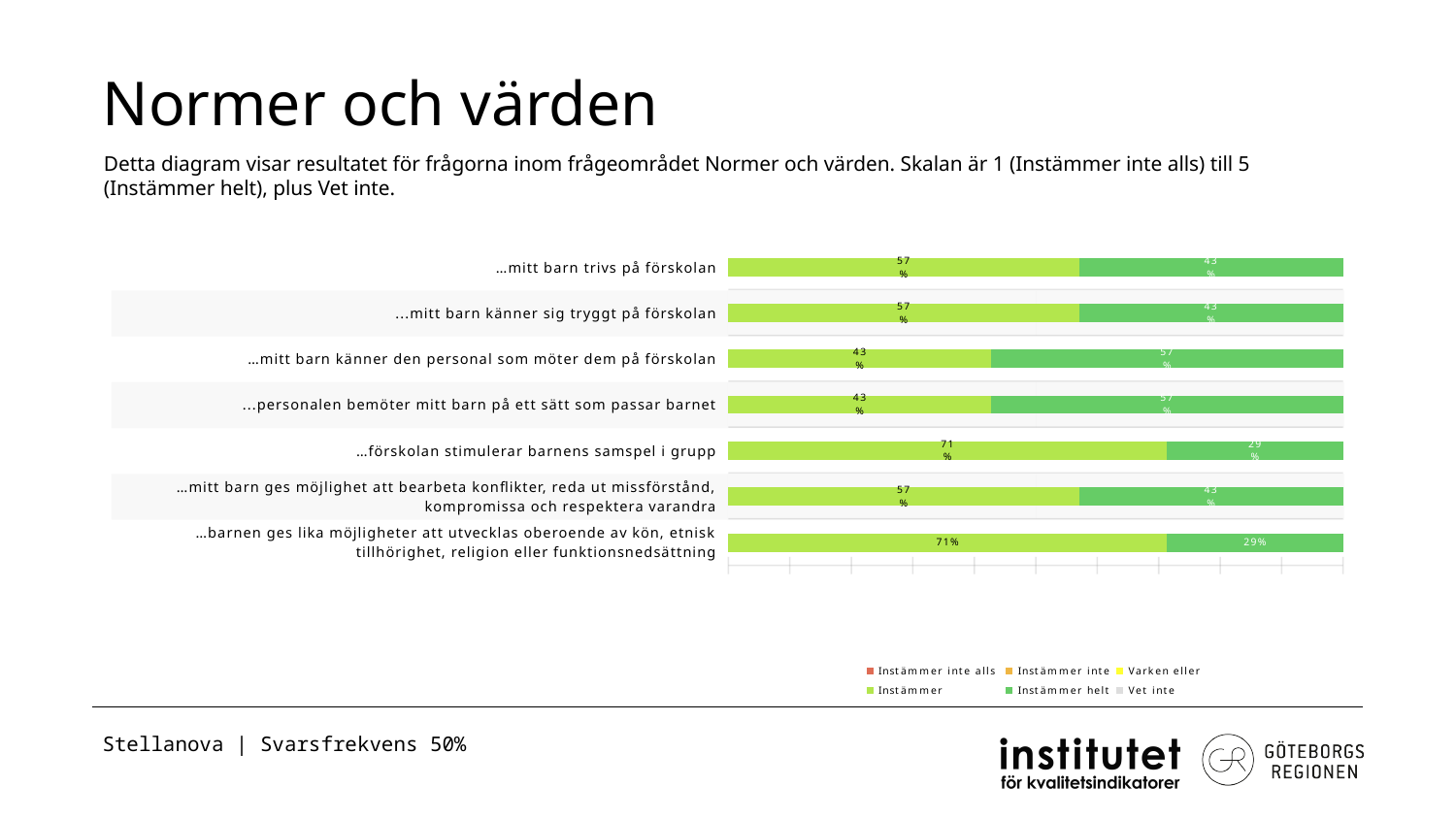
What is the title of the slide containing the chart? Normer och värden What kind of chart is shown on the slide? stacked bar chart How many categories (questions) are plotted in the chart? 7 Which category has the lowest Instämmer helt value? …förskolan stimulerar barnens samspel i grupp and …barnen ges lika möjligheter att utvecklas oberoende av kön, etnisk tillhörighet, religion eller funktionsnedsättning (29%) Which is larger for "…mitt barn känner sig tryggt på förskolan": Instämmer or Instämmer helt? Instämmer What is the total of the stacked bar for "…mitt barn ges möjlighet att bearbeta konflikter, reda ut missförstånd, kompromissa och respektera varandra"? 100% How many series does the legend list? 6 What is the difference between the Instämmer and Instämmer helt values for "…personalen bemöter mitt barn på ett sätt som passar barnet"? 14% What is the Instämmer value for "…mitt barn trivs på förskolan"? 57% What is the Instämmer helt value for "…barnen ges lika möjligheter att utvecklas oberoende av kön, etnisk tillhörighet, religion eller funktionsnedsättning"? 29% What is the Instämmer value for "…förskolan stimulerar barnens samspel i grupp"? 71% What is the Instämmer helt value for "…mitt barn känner den personal som möter dem på förskolan"? 57%